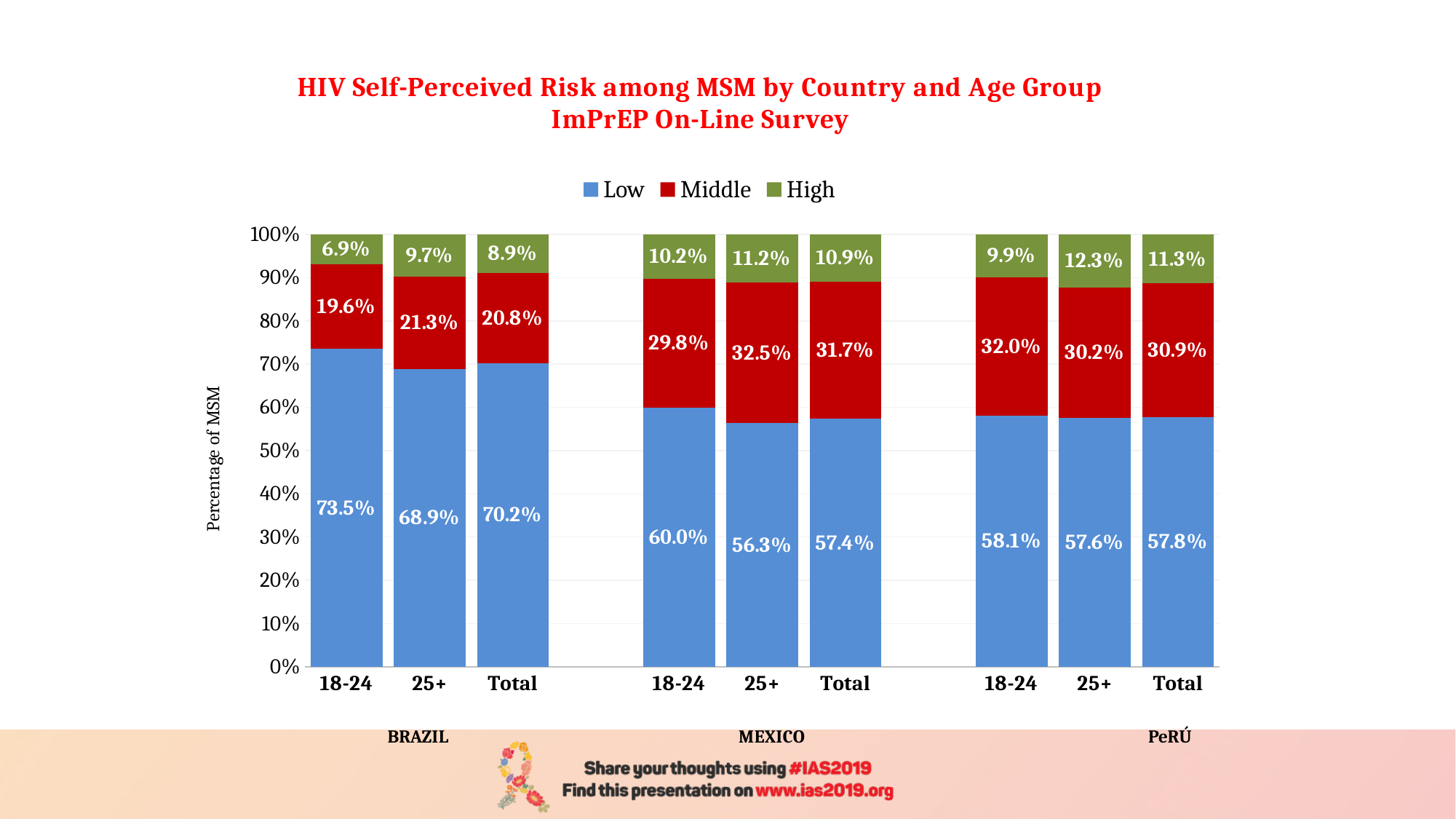
What is the High self-perceived risk value for the 25+ age group in Peru? 12.3% Is the Low value for Mexico 25+ greater or less than 60%? less What percentage of MSM aged 18-24 in Brazil reported Low self-perceived HIV risk? 73.5% What kind of chart is shown on the slide? Stacked bar chart Which bar has the lowest High self-perceived risk value? Brazil 18-24 How many series does the legend list? 3 Which bar has the highest Low self-perceived risk value? Brazil 18-24 How many bars are plotted on the chart? 9 What is the difference between the Low values for Brazil 18-24 and Brazil 25+? 4.6% Which colour represents the Middle risk category in the legend? Red What is the Middle self-perceived risk value for the Total group in Mexico? 31.7% Which is larger, the Middle value for Mexico 25+ or the Middle value for Peru 25+? Mexico 25+